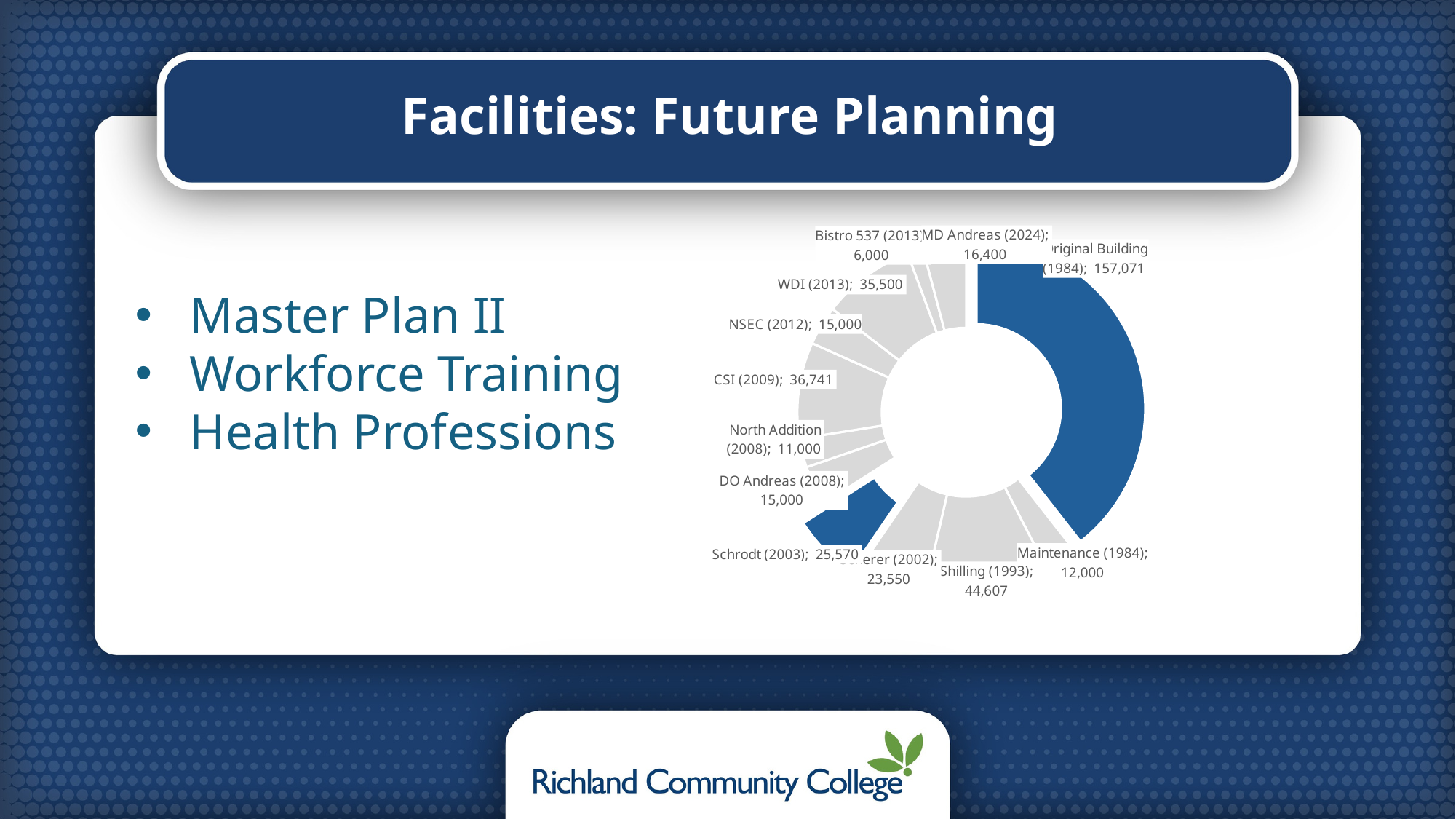
Which is larger, Shilling (1993) or CSI (2009)? Shilling (1993) Which two slices are highlighted in dark blue? Original Building (1984) and Schrodt (2003) What is the value for Shilling (1993)? 44,607 What is the value for Original Building (1984)? 157,071 How many categories (slices) does the chart show? 12 Which category has the smallest value? Bistro 537 (2013) Which category has the largest value? Original Building (1984) What is the difference between WDI (2013) and NSEC (2012)? 20,500 What kind of chart is shown on the slide? Doughnut (pie) chart What is the value for MD Andreas (2024)? 16,400 What is the value for CSI (2009)? 36,741 What is the difference between Original Building (1984) and Maintenance (1984)? 145,071